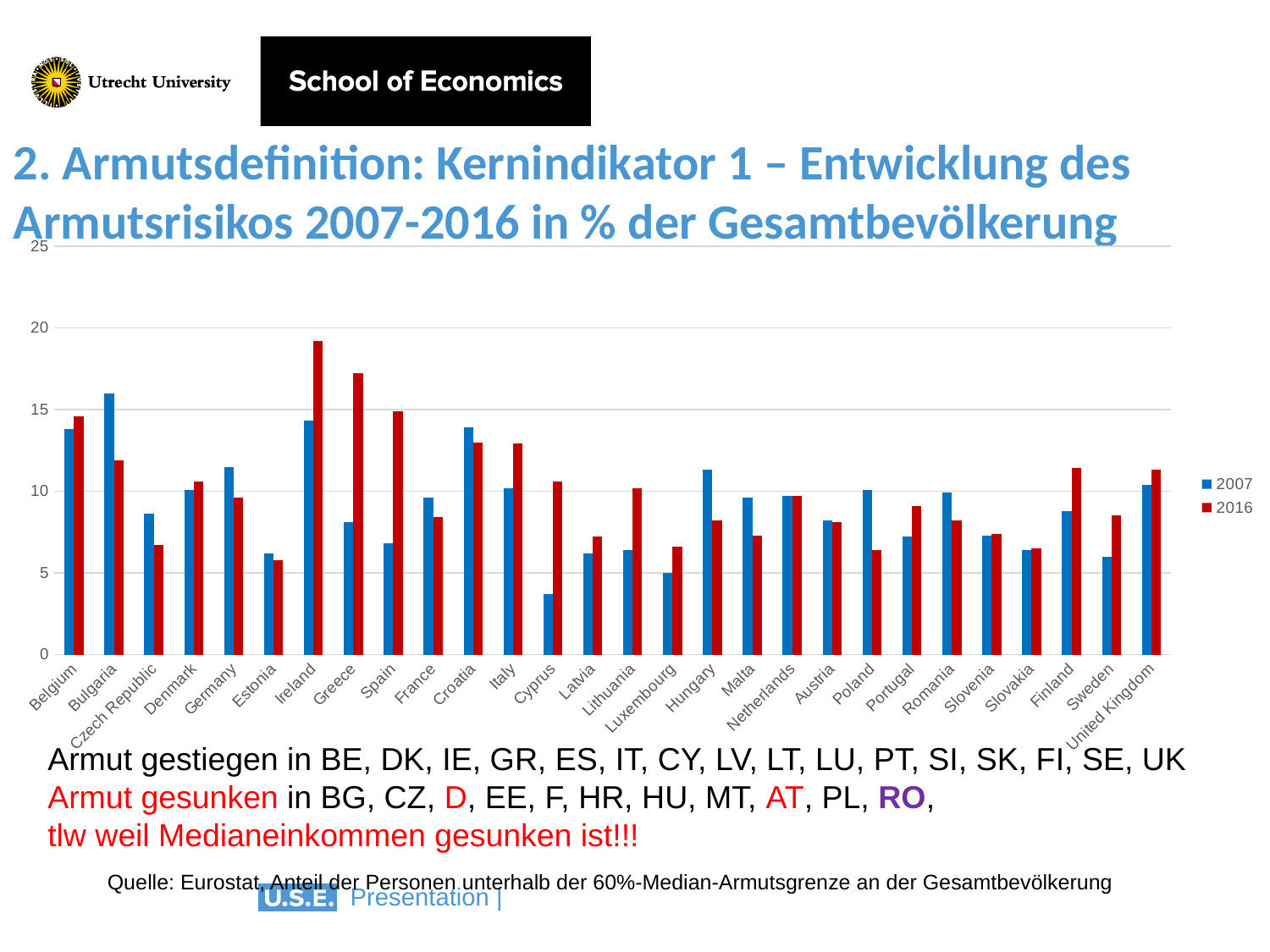
Which country has the highest value for 2016? Ireland Which country has the highest value for 2007? Bulgaria How many countries are shown on the x axis of the chart? 28 How many series does the legend list? 2 For Bulgaria, which year has the larger value, 2007 or 2016? 2007 Which colour represents the 2016 series in the legend? red Is the 2007 value for Bulgaria greater or less than 15? greater Which country has the lowest value for 2007? Cyprus Is the 2007 value for Cyprus greater or less than 5? less What kind of chart is shown on the slide? bar chart For Greece, which year has the larger value, 2007 or 2016? 2016 Is the 2016 value for Ireland greater or less than 15? greater